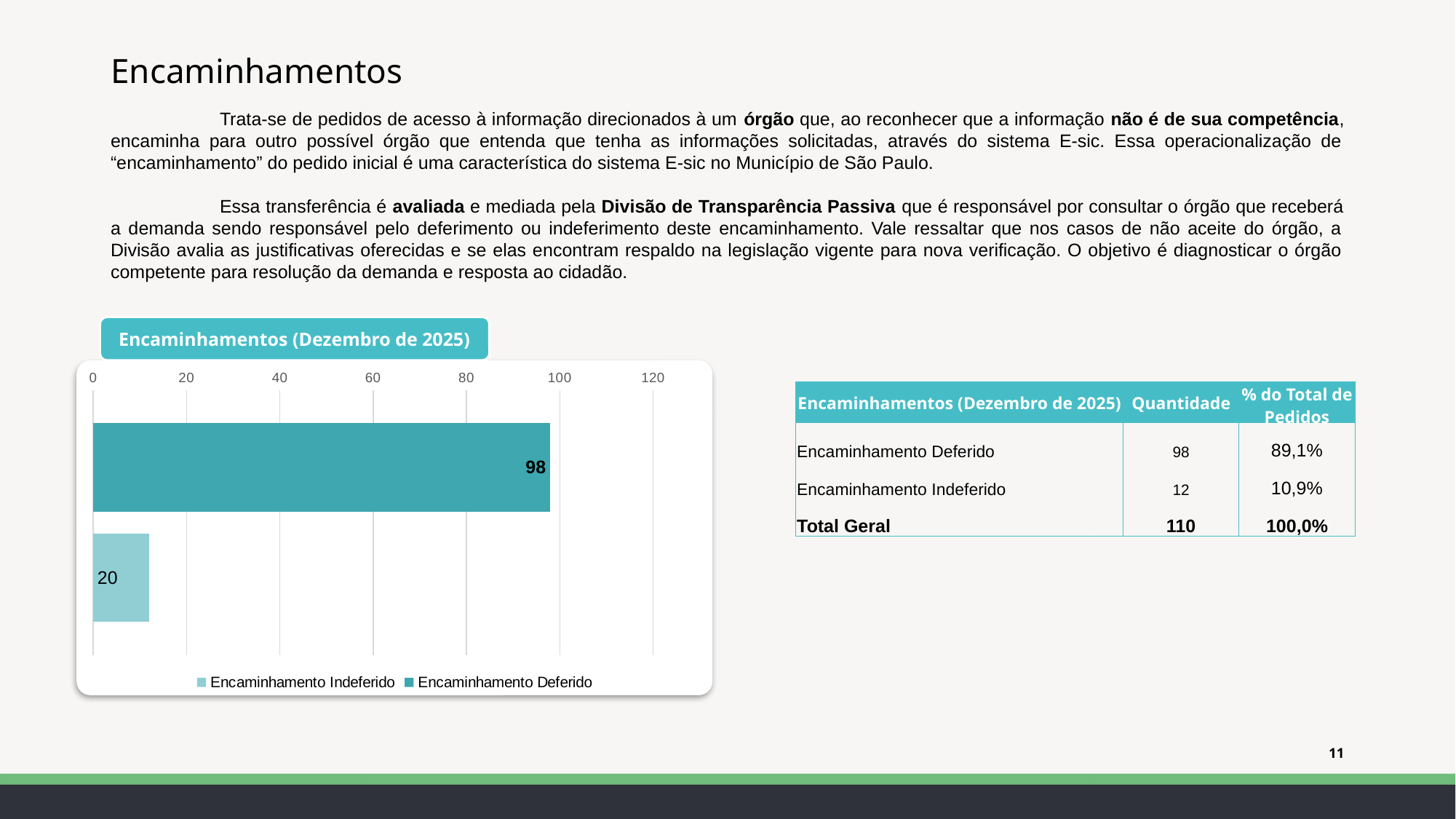
Which series has the highest value in the chart? Encaminhamento Deferido Is the value for Encaminhamento Deferido greater or less than 80? greater Which is larger in the chart, Encaminhamento Deferido or Encaminhamento Indeferido? Encaminhamento Deferido Is the value for Encaminhamento Deferido greater or less than 100? less What kind of chart is shown on the slide? bar chart How many bars are plotted in the chart? 2 Is the bar for Encaminhamento Indeferido greater or less than 40? less What is the title of the chart? Encaminhamentos (Dezembro de 2025) Which series is drawn in the darker teal colour in the chart? Encaminhamento Deferido What is the value shown for Encaminhamento Deferido in the chart? 98 Which series has the lowest value in the chart? Encaminhamento Indeferido How many series does the chart legend list? 2